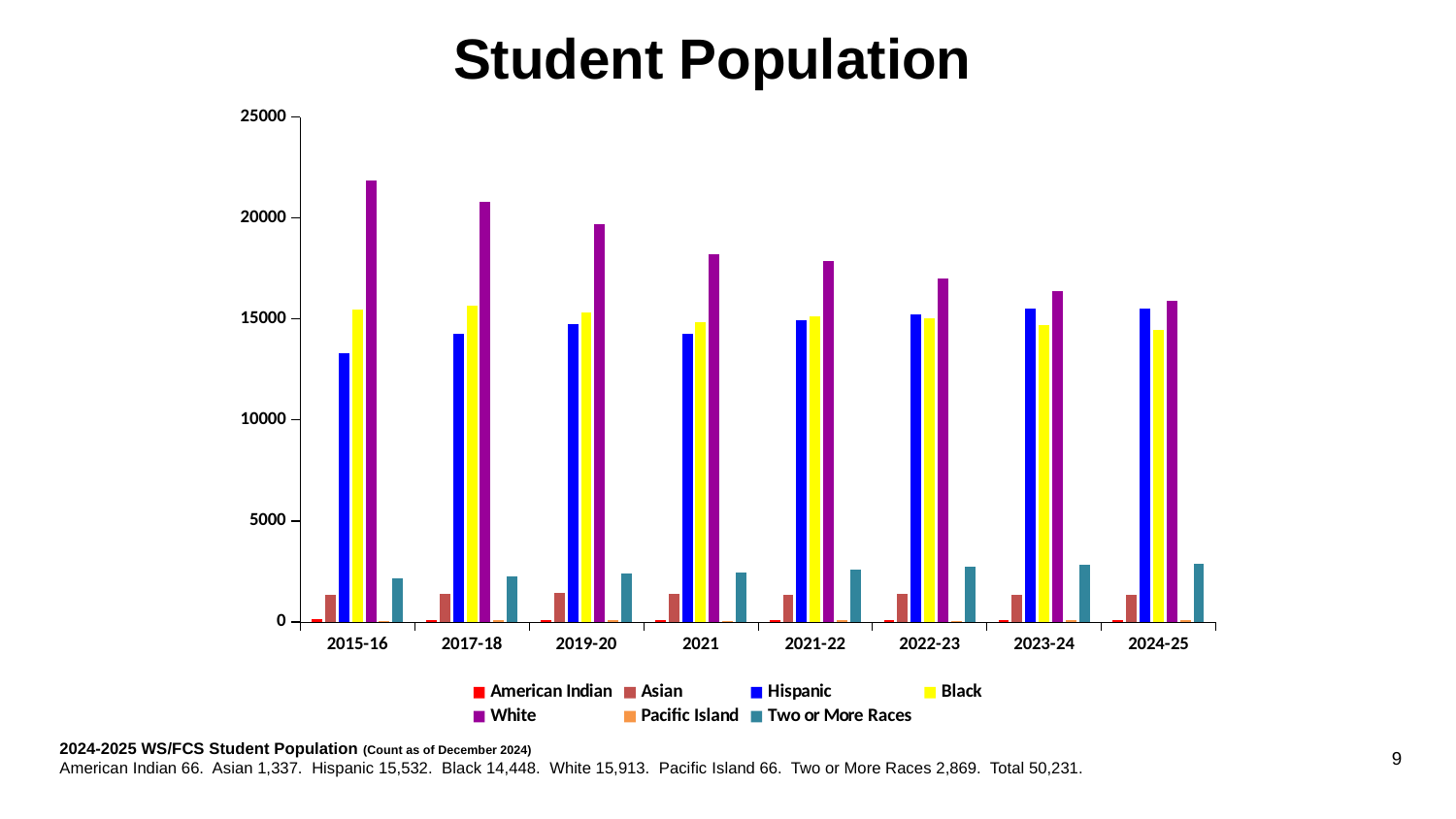
Does the White series rise or fall from 2015-16 to 2024-25? fall What kind of chart is shown on the slide? bar chart According to the text below the chart, what is the total student population for 2024-2025? 50,231 Which group has the highest bar in 2015-16? White How many school-year categories are shown on the x axis? 8 What is the difference between the White and Hispanic counts for 2024-2025 given in the text below the chart? 381 Is the value for White in 2015-16 greater or less than 20000? greater According to the text below the chart, what is the White student count for 2024-2025? 15,913 Is the value for Hispanic in 2015-16 greater or less than 15000? less How many series does the legend list? 7 According to the text below the chart, what is the Hispanic student count for 2024-2025? 15,532 In 2024-2025, which is larger, the Hispanic count or the Black count? Hispanic